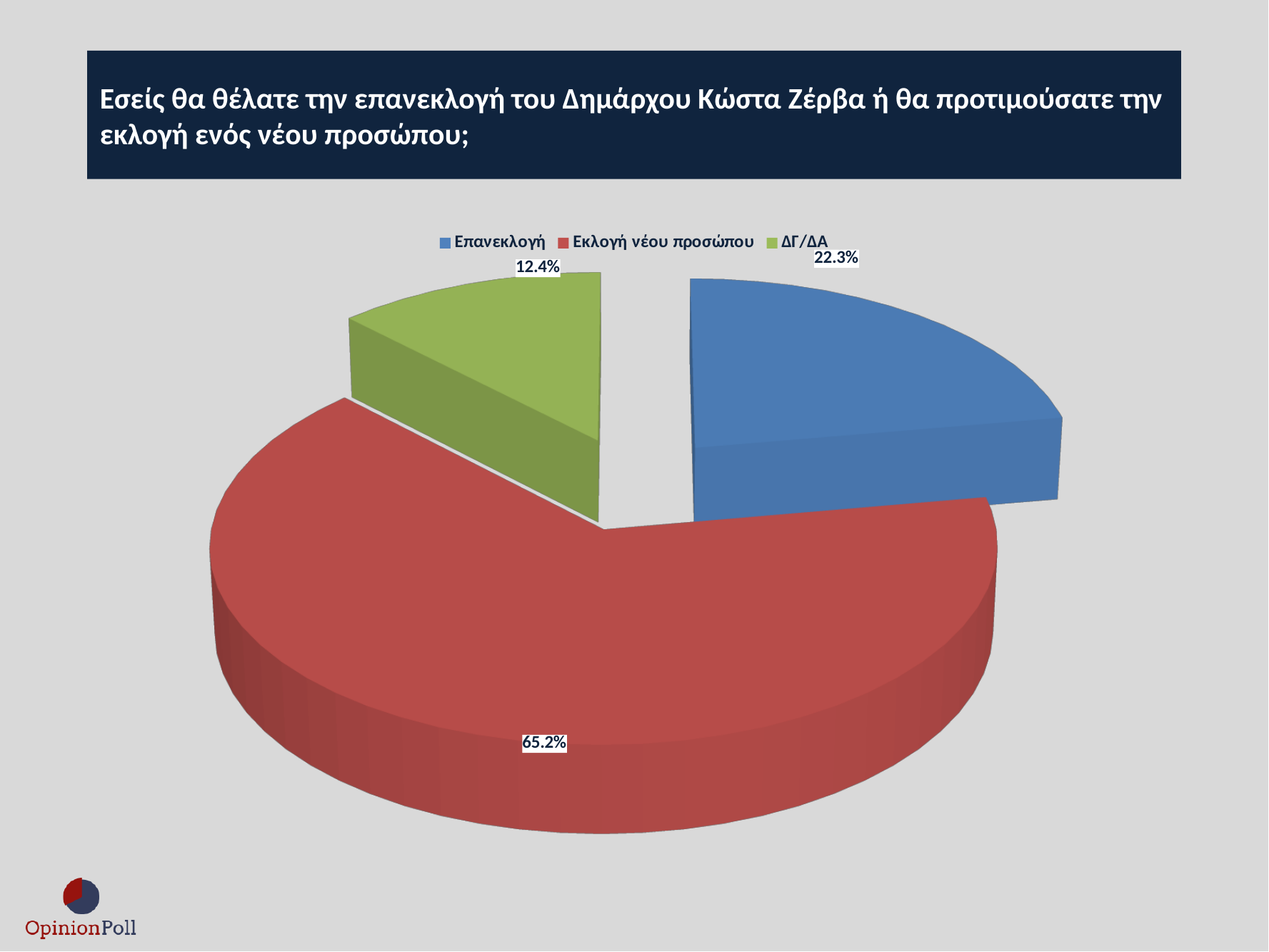
Which response has the smallest share of the pie? ΔΓ/ΔΑ How many entries does the legend list? 3 What colour is the slice for Εκλογή νέου προσώπου? Red How many slices does the pie chart have? 3 What is the difference in percentage points between Εκλογή νέου προσώπου and Επανεκλογή? 42.9 Which response has the largest share of the pie? Εκλογή νέου προσώπου What kind of chart is shown on the slide? Pie chart What percentage of respondents chose Εκλογή νέου προσώπου? 65.2% What percentage of respondents chose Επανεκλογή? 22.3% Which is larger, the share for Επανεκλογή or the share for ΔΓ/ΔΑ? Επανεκλογή What percentage of respondents answered ΔΓ/ΔΑ? 12.4% What is the difference in percentage points between Επανεκλογή and ΔΓ/ΔΑ? 9.9